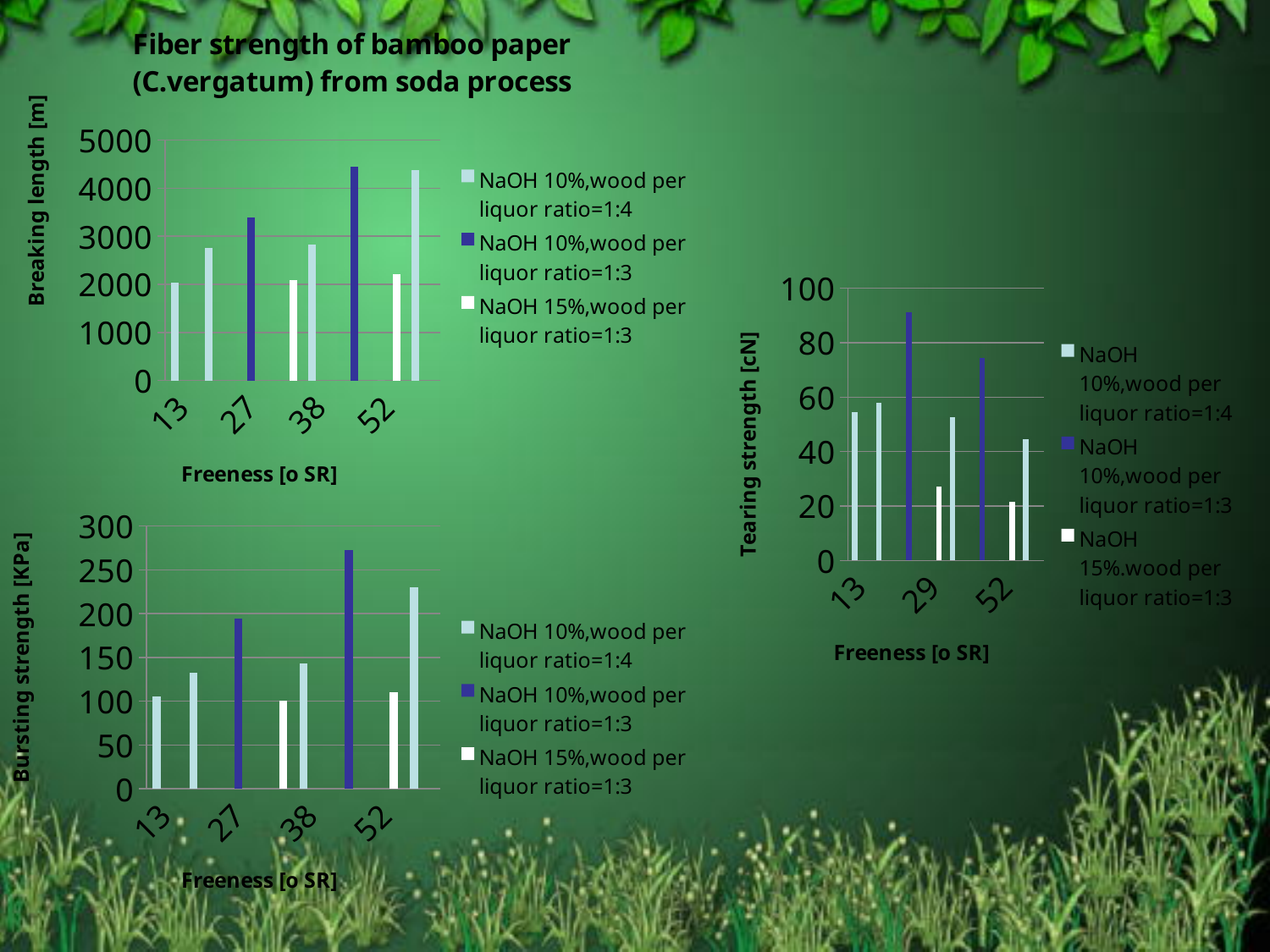
In the Tearing strength chart, how many freeness categories are shown on the x axis? 3 What is the y-axis title of the chart on the right side of the slide? Tearing strength [cN] In the Tearing strength chart, is the value for NaOH 10%, wood per liquor ratio=1:3 at freeness 29 greater or less than 80? greater In the Bursting strength chart, is the value for NaOH 15%, wood per liquor ratio=1:3 at freeness 38 greater or less than 150? less In the Breaking length chart, is the value for NaOH 10%, wood per liquor ratio=1:3 at freeness 27 greater or less than 3000? greater How many series does the legend of the Bursting strength chart list? 3 What kind of chart is the Breaking length chart on the slide? bar chart In the Bursting strength chart at freeness 52, which is larger: NaOH 10% with wood per liquor ratio=1:3 or NaOH 10% with wood per liquor ratio=1:4? NaOH 10%, wood per liquor ratio=1:3 In the Breaking length chart, how many freeness categories are shown on the x axis? 4